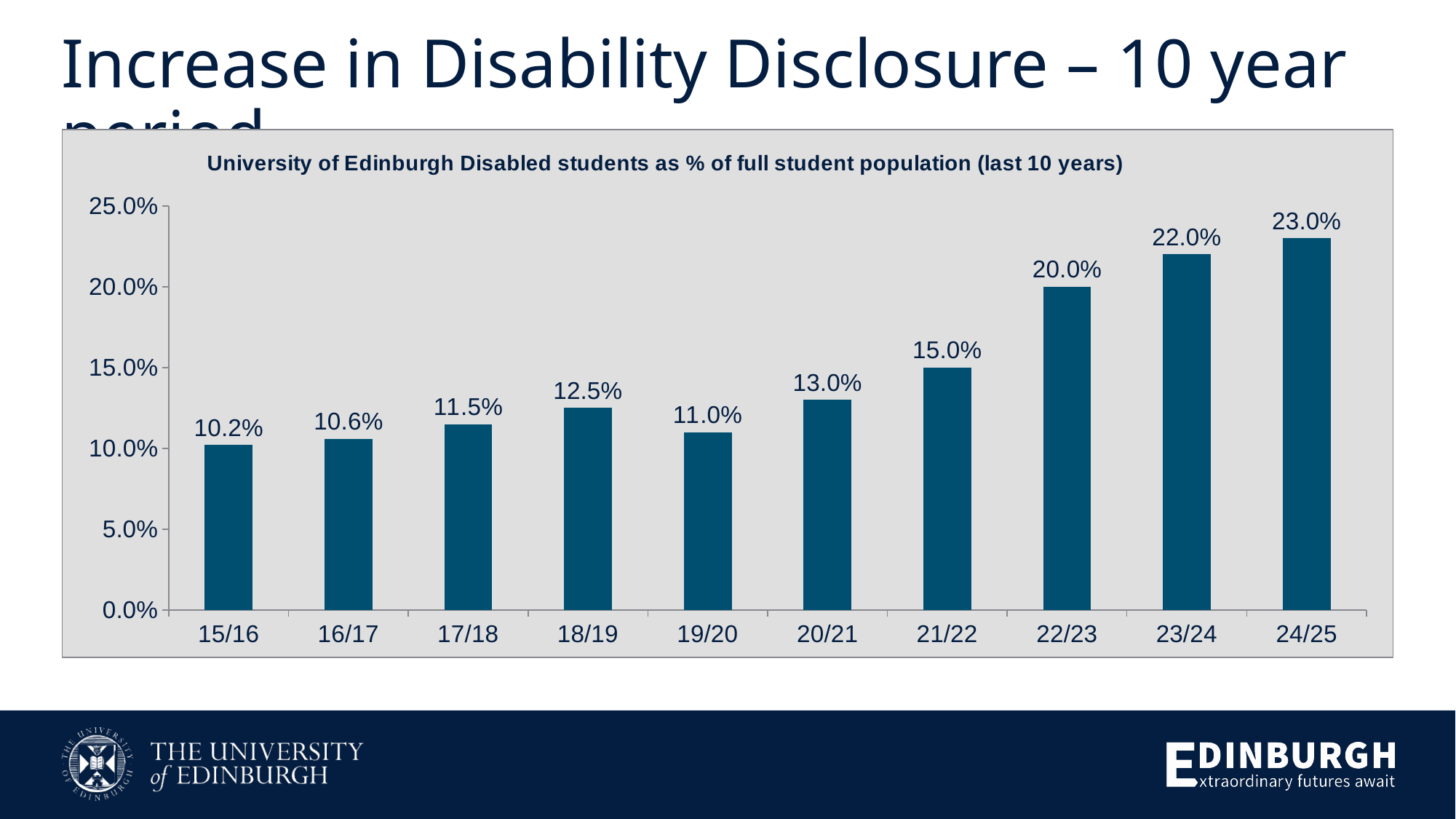
What is the value for 22/23? 20.0% What is the difference between the values for 24/25 and 15/16? 12.8% Do the values generally rise or fall from 15/16 to 24/25? Rise What is the title of the chart? University of Edinburgh Disabled students as % of full student population (last 10 years) What is the difference between the values for 18/19 and 19/20? 1.5% What kind of chart is shown on the slide? Bar chart What is the value for 19/20? 11.0% Which year has the highest value? 24/25 Which year has the lowest value? 15/16 How many years are shown on the x axis? 10 What is the value for 15/16? 10.2% Which is larger, the value for 18/19 or the value for 19/20? 18/19